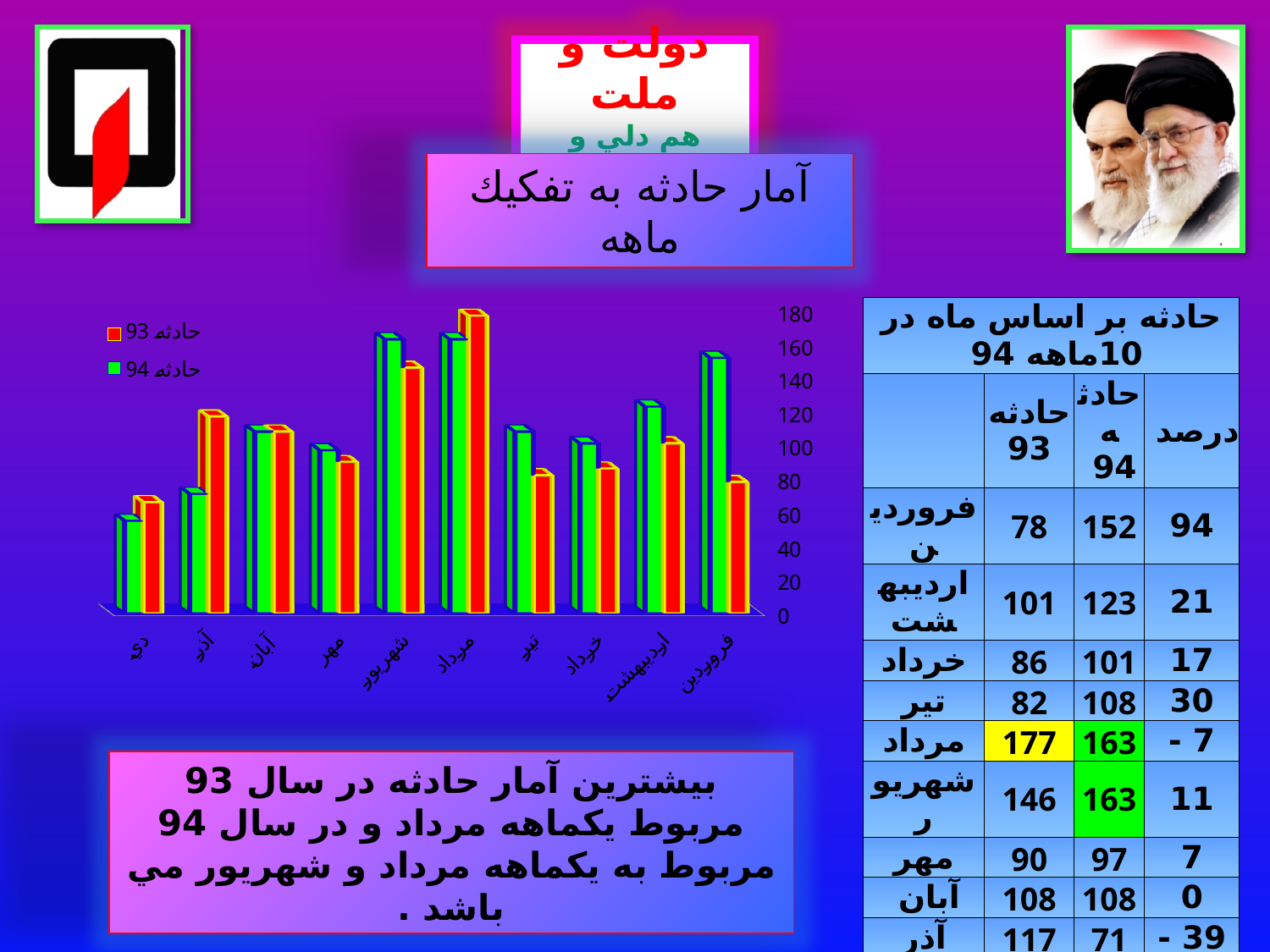
Is the حادثه 94 value for فروردين greater or less than 140? greater For فروردين, which series has the taller bar, حادثه 93 or حادثه 94? حادثه 94 Is the حادثه 94 value for دي greater or less than 80? less How many month categories are shown on the x axis of the chart? 10 Which month has the highest bar for the حادثه 93 series? مرداد Which series in the chart is drawn in green? حادثه 94 For آذر, which series has the taller bar, حادثه 93 or حادثه 94? حادثه 93 What kind of chart is shown on the slide? bar chart Is the حادثه 93 value for آذر greater or less than 100? greater For شهريور, which series has the taller bar, حادثه 93 or حادثه 94? حادثه 94 How many series does the chart legend list? 2